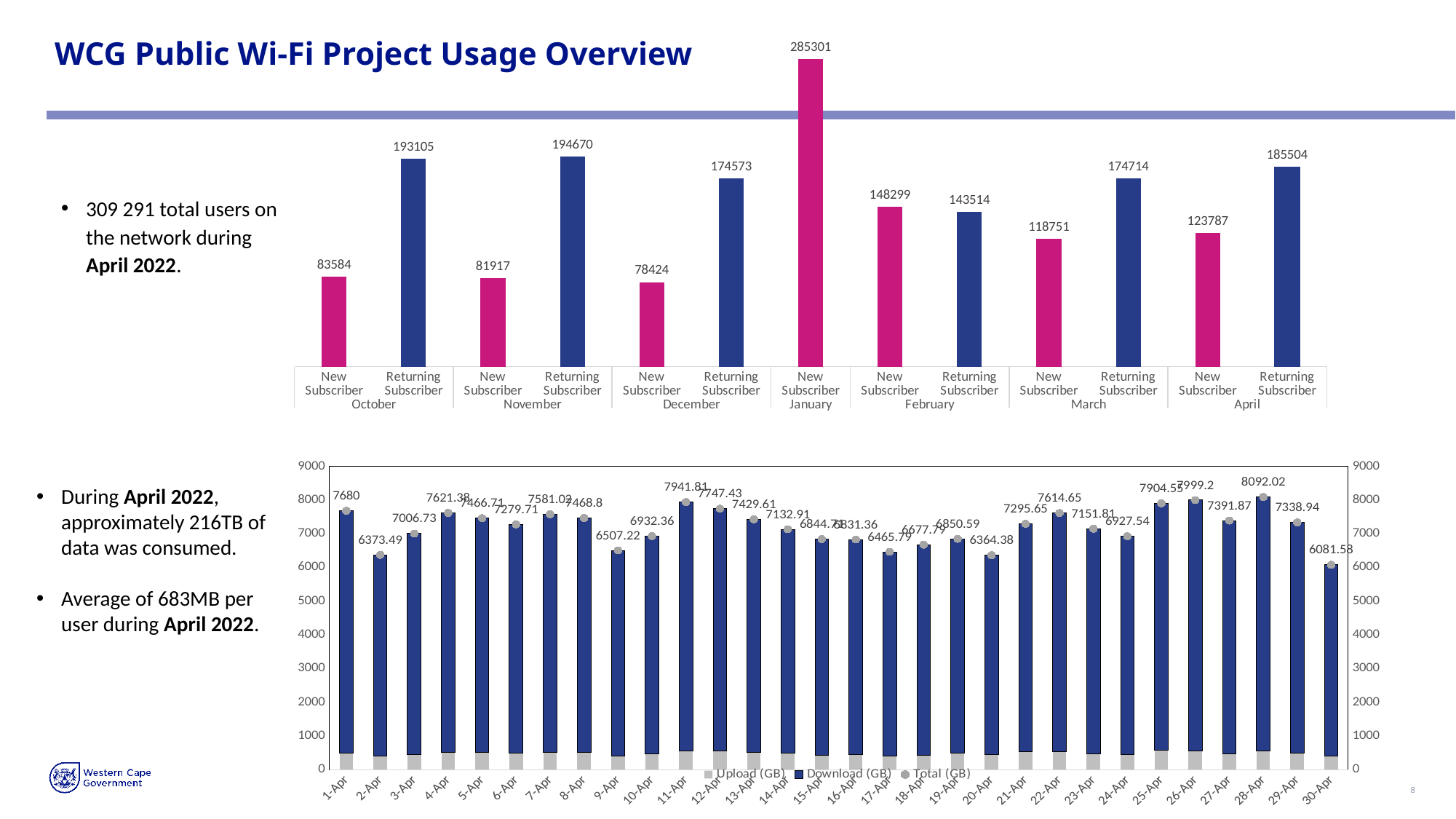
In the bottom chart, how many series does the legend list? 3 In the top chart, how many New Subscribers were there in January? 285301 In the top chart, what is the difference between Returning Subscribers and New Subscribers in October? 109521 What kind of chart is the bottom chart? Combination chart: stacked bar chart (Upload and Download) with Total plotted as line markers In the bottom chart, what is the Total (GB) value for 28-Apr? 8092.02 In the top chart, which is larger in February: New Subscribers or Returning Subscribers? New Subscribers In the top chart, how many bars are plotted? 13 In the top chart, which bar has the lowest value? New Subscriber, December In the bottom chart, is the Download (GB) value for 2-Apr greater or less than 7000? less In the top chart, which bar has the highest value? New Subscriber, January In the top chart, how many Returning Subscribers were there in April? 185504 In the bottom chart, which day has the lowest Total (GB)? 30-Apr